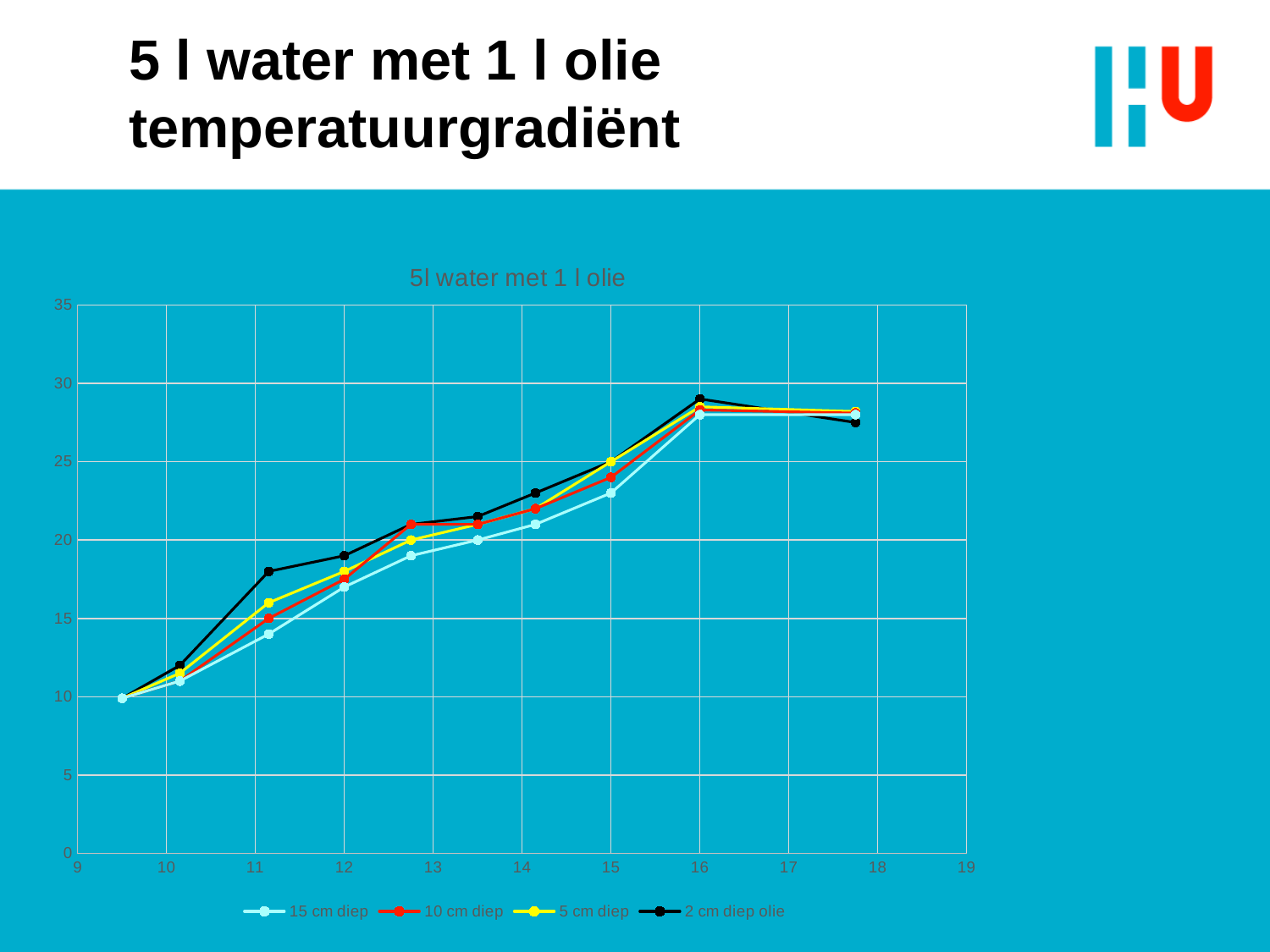
What kind of chart is shown on the slide? line chart What is the title of the chart? 5l water met 1 l olie At x=12, which is higher: 2 cm diep olie or 15 cm diep? 2 cm diep olie Which series has the highest value at x=16? 2 cm diep olie Is the value for 2 cm diep olie at x=16 greater or less than 25? greater How many series does the legend list? 4 Is the value for 2 cm diep olie at x=12 greater or less than 15? greater How many data points does each series have? 10 Is the value for 15 cm diep at x=12 greater or less than 20? less Which series is drawn in black? 2 cm diep olie Do the values for 15 cm diep generally rise or fall from x=9 to x=16? rise